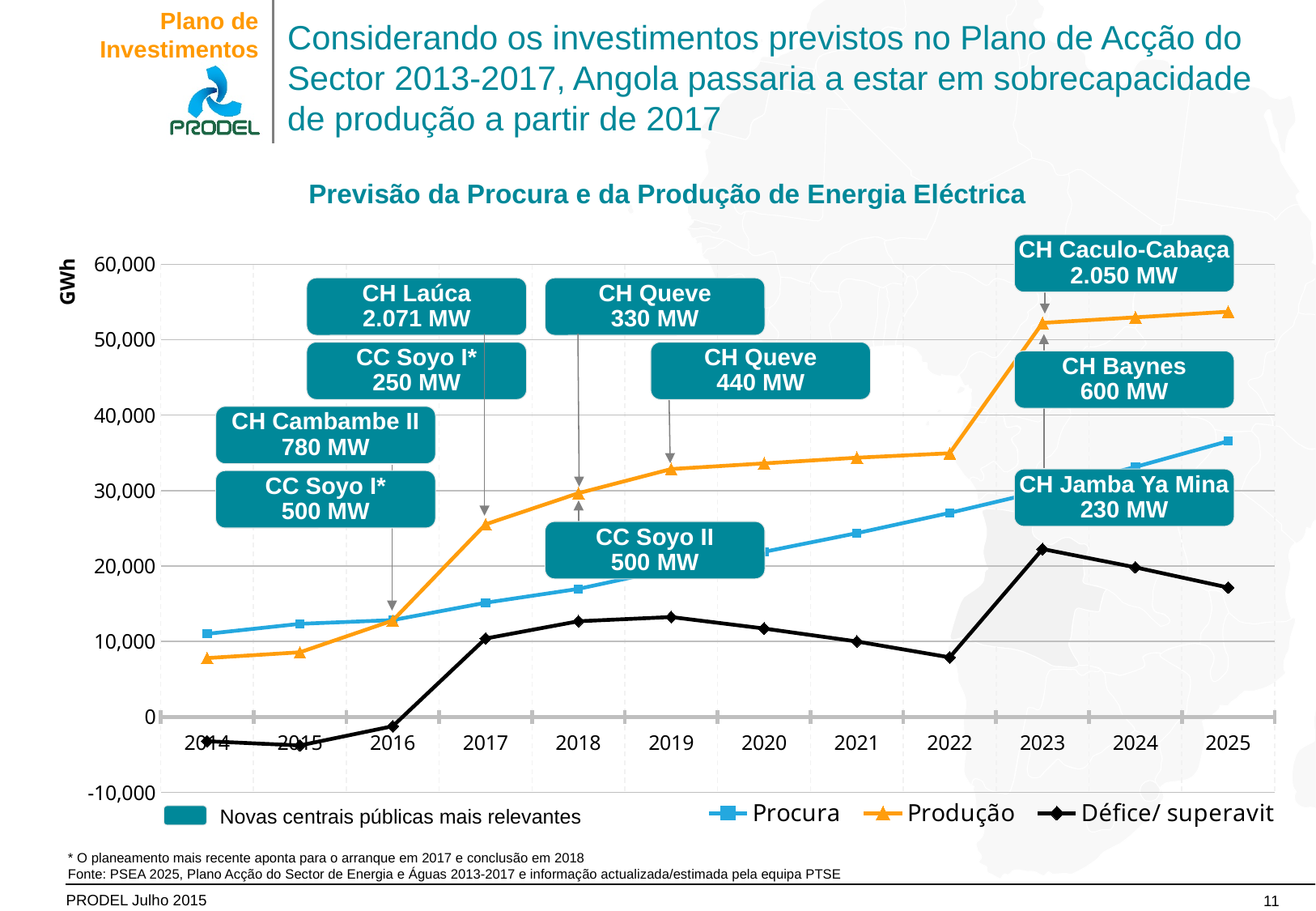
Is the value for Procura in 2025 greater or less than 40,000? less In 2017, which is larger: Procura or Produção? Produção In which year is Produção lowest? 2014 In which year is Procura lowest? 2014 Is the value for Produção in 2023 greater or less than 50,000? greater How many series does the chart legend list? 3 In which year is Produção highest? 2025 In which year is Défice/ superavit highest? 2023 Does Procura rise or fall from 2014 to 2025? rise Is the value for Défice/ superavit in 2014 greater or less than 0? less What kind of chart is shown on the slide? line chart How many years are plotted along the x axis? 12